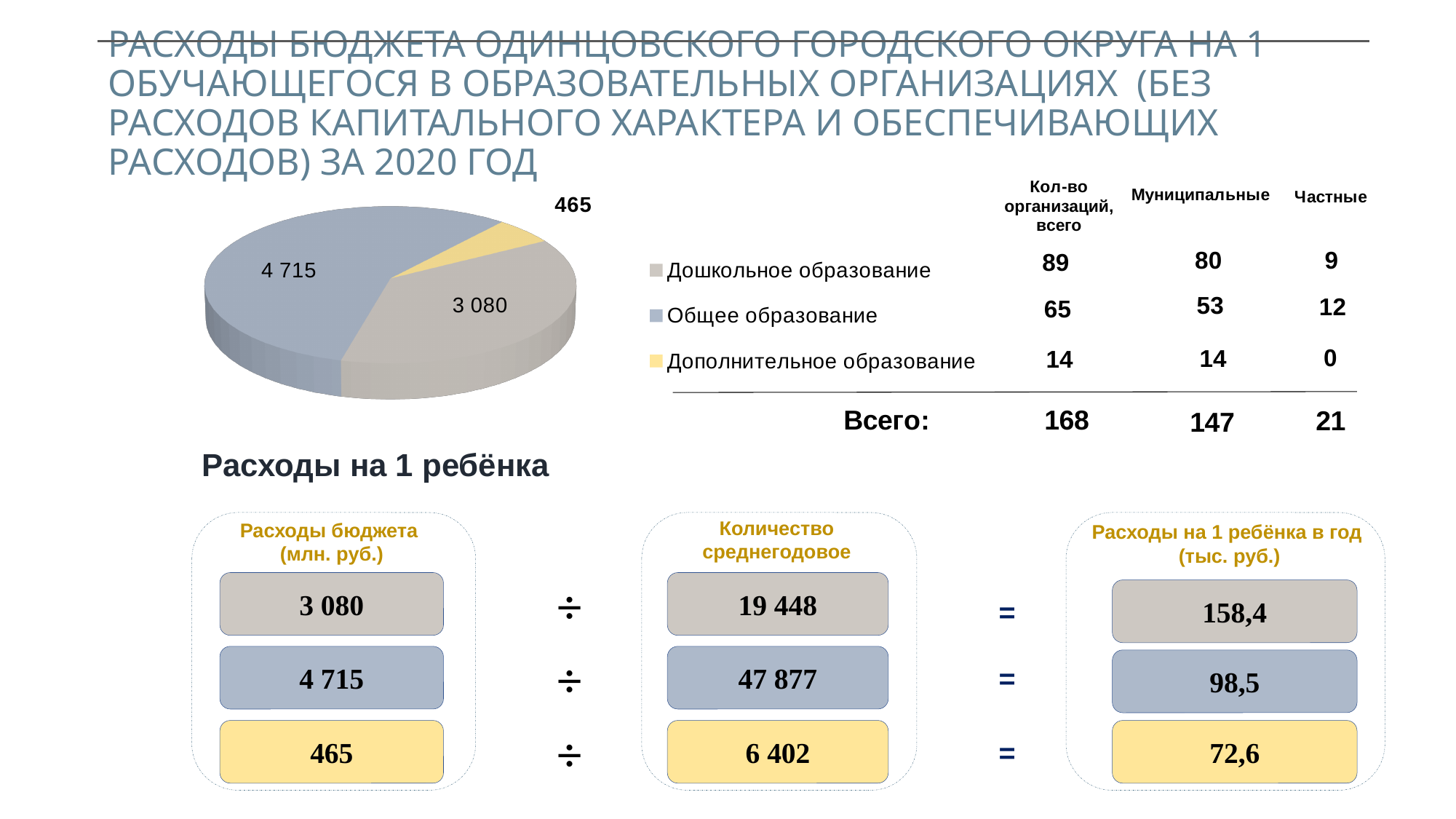
What is the value of the Дошкольное образование slice in the pie chart? 3 080 What is the value of the Дополнительное образование slice in the pie chart? 465 Which category has the smallest slice in the pie chart? Дополнительное образование What is the difference between the Общее образование and Дошкольное образование values in the pie chart? 1 635 Which is larger in the pie chart: Дошкольное образование or Дополнительное образование? Дошкольное образование What is the value of the Общее образование slice in the pie chart? 4 715 How many entries does the pie chart legend list? 3 What colour is the Дополнительное образование slice in the pie chart? yellow What is the total of all three slices in the pie chart? 8 260 How many slices does the pie chart have? 3 What type of chart is shown on the slide? pie chart Which category has the largest slice in the pie chart? Общее образование